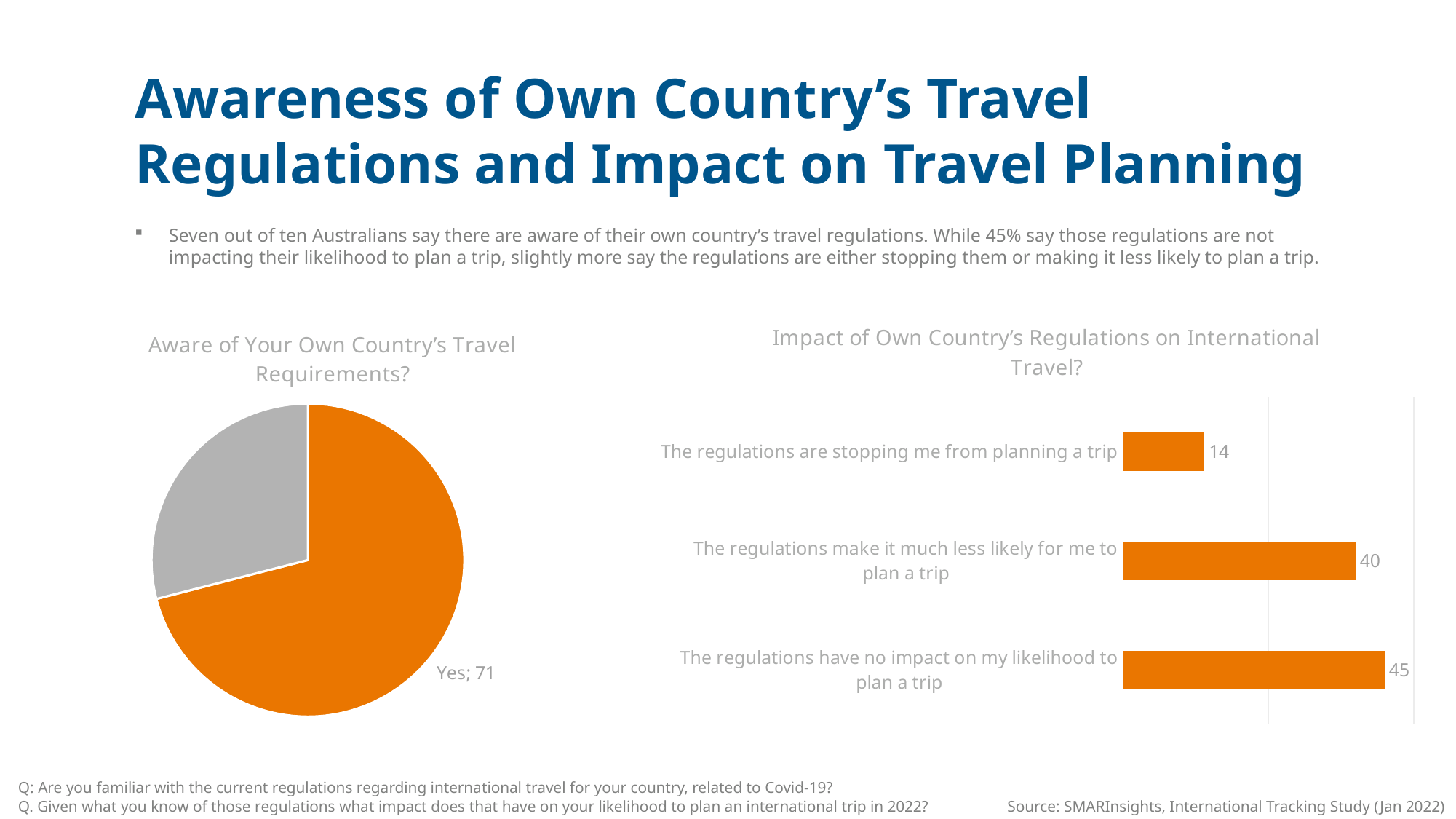
In the 'Aware of Your Own Country's Travel Requirements?' chart, what is the value for the 'Yes' slice? 71 In the 'Impact of Own Country's Regulations on International Travel?' chart, what is the difference between the 'no impact' value and the 'stopping me from planning a trip' value? 31 How many categories are shown in the 'Impact of Own Country's Regulations on International Travel?' chart? 3 In the 'Impact of Own Country's Regulations on International Travel?' chart, what is the value for 'The regulations are stopping me from planning a trip'? 14 What kind of chart is the 'Aware of Your Own Country's Travel Requirements?' chart? Pie chart What kind of chart is the 'Impact of Own Country's Regulations on International Travel?' chart? Bar chart In the 'Aware of Your Own Country's Travel Requirements?' pie chart, what colour is the 'Yes' slice? Orange In the 'Impact of Own Country's Regulations on International Travel?' chart, what is the value for 'The regulations make it much less likely for me to plan a trip'? 40 In the 'Impact of Own Country's Regulations on International Travel?' chart, what is the value for 'The regulations have no impact on my likelihood to plan a trip'? 45 In the 'Impact of Own Country's Regulations on International Travel?' chart, which is larger: 'much less likely' or 'no impact'? The regulations have no impact on my likelihood to plan a trip In the 'Impact of Own Country's Regulations on International Travel?' chart, which category has the highest value? The regulations have no impact on my likelihood to plan a trip In the 'Impact of Own Country's Regulations on International Travel?' chart, which category has the lowest value? The regulations are stopping me from planning a trip